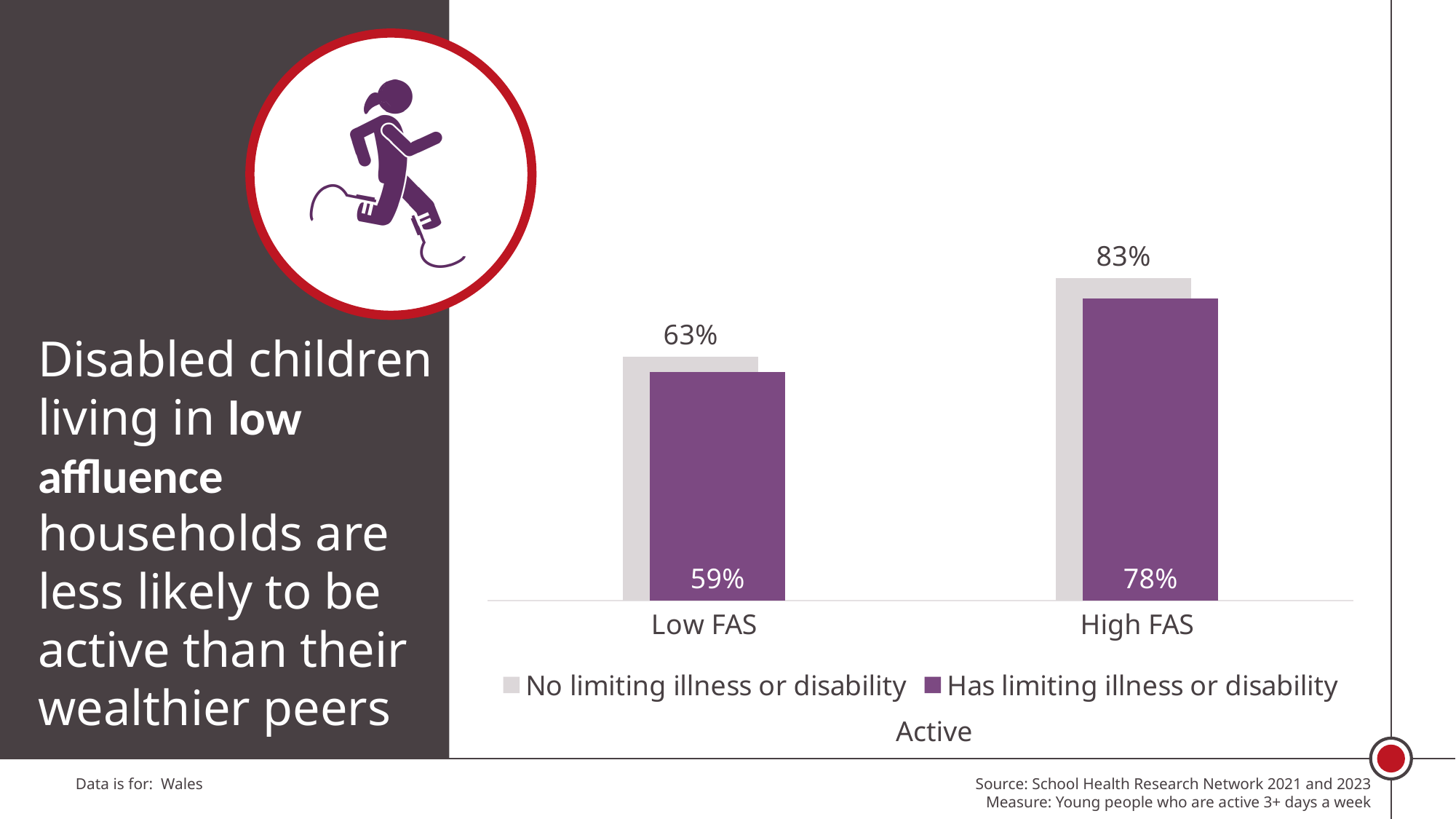
What is the value for 'Has limiting illness or disability' in the High FAS category? 78% How many series does the legend list? 2 What is the difference between the two series in the Low FAS category? 4% What is the value for 'No limiting illness or disability' in the High FAS category? 83% Which category has the highest value for 'Has limiting illness or disability'? High FAS What is the value for 'No limiting illness or disability' in the Low FAS category? 63% How many categories are shown on the x axis? 2 What is the value for 'Has limiting illness or disability' in the Low FAS category? 59% What kind of chart is shown on the slide? Bar chart What is the difference between the two series in the High FAS category? 5% Which category has the lowest value for 'No limiting illness or disability'? Low FAS In the High FAS category, which series has the larger value? No limiting illness or disability